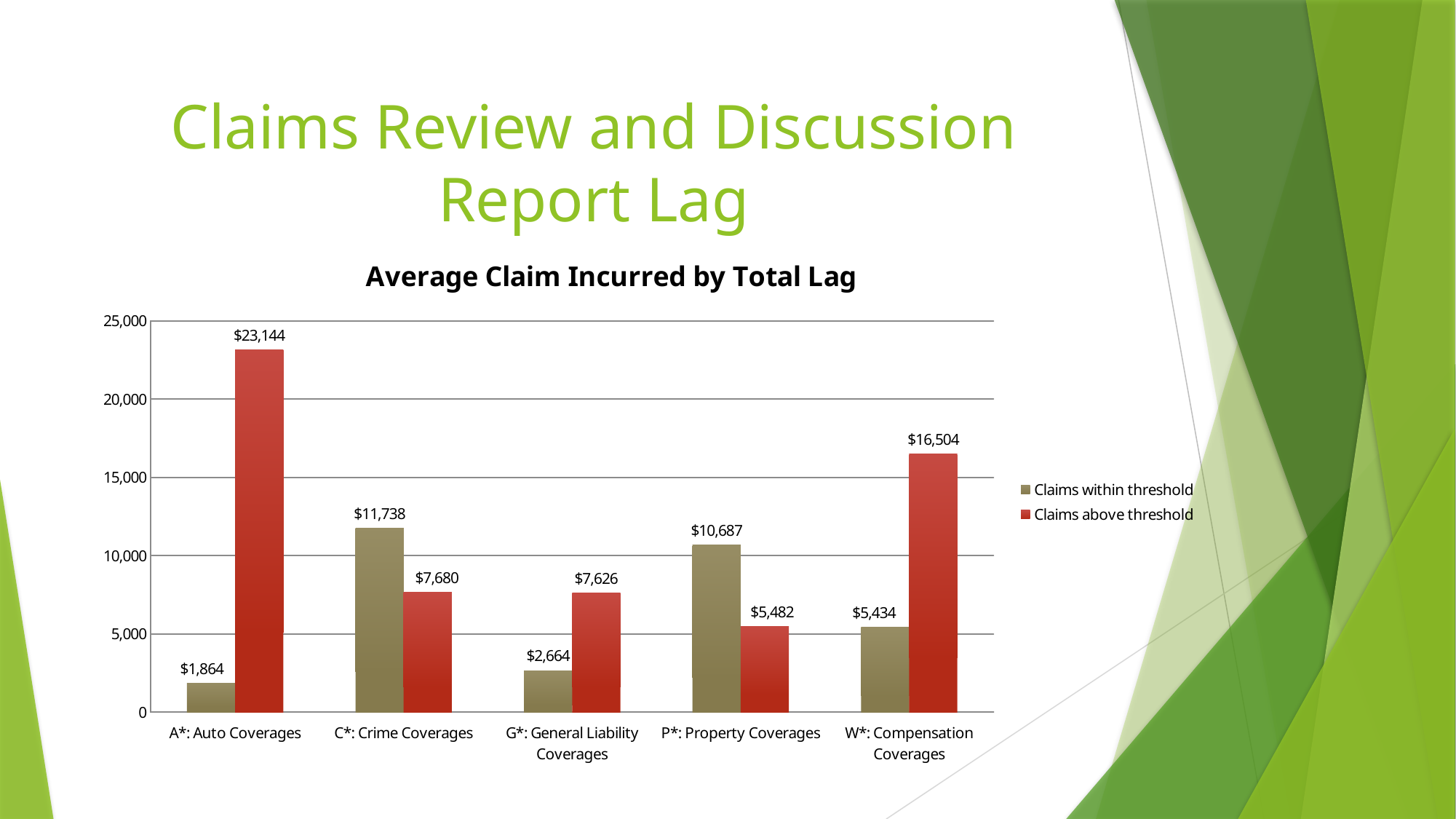
What is the value of Claims above threshold for A*: Auto Coverages? $23,144 What is the difference between Claims above threshold and Claims within threshold for W*: Compensation Coverages? $11,070 What is the value of Claims within threshold for C*: Crime Coverages? $11,738 Which category has the highest value for Claims above threshold? A*: Auto Coverages How many coverage categories are shown on the x axis? 5 Which category has the highest value for Claims within threshold? C*: Crime Coverages What is the value of Claims within threshold for G*: General Liability Coverages? $2,664 Which category has the lowest value for Claims within threshold? A*: Auto Coverages What type of chart is shown on the slide? bar chart Is the value of Claims within threshold for P*: Property Coverages greater or less than 10,000? greater For C*: Crime Coverages, which is larger: Claims within threshold or Claims above threshold? Claims within threshold How many series does the legend list? 2